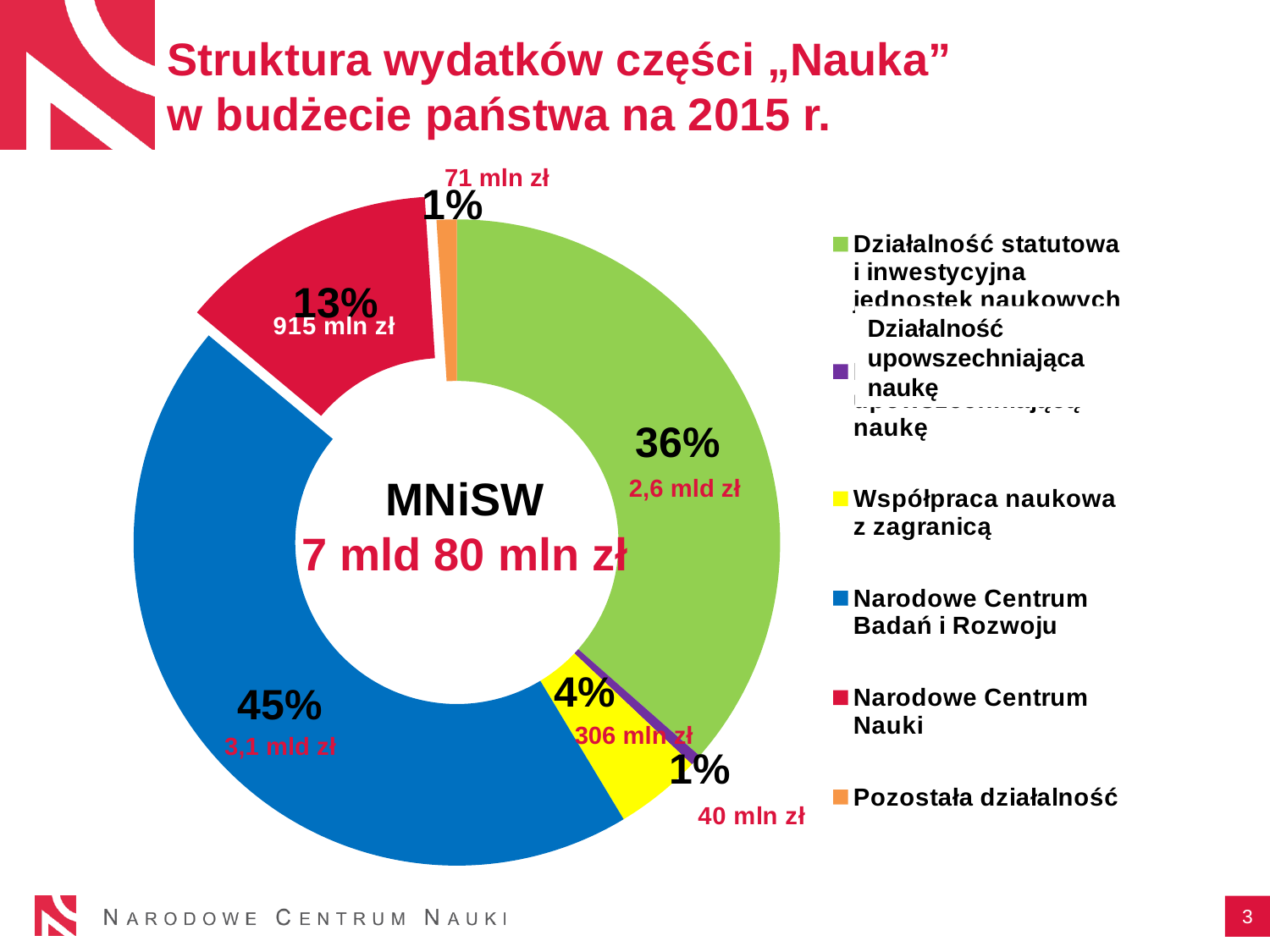
What total amount is shown in the centre of the chart? 7 mld 80 mln zł Which category has the largest share of the chart? Narodowe Centrum Badań i Rozwoju What kind of chart is shown on the slide? Doughnut (pie) chart What share of the chart does Narodowe Centrum Badań i Rozwoju hold? 45% What is the difference in percentage points between the share for Narodowe Centrum Badań i Rozwoju and the share for Działalność statutowa i inwestycyjna jednostek naukowych? 9 percentage points What share of the chart does Narodowe Centrum Nauki hold? 13% How many categories does the legend list? 6 Which is larger: the share for Narodowe Centrum Nauki or the share for Współpraca naukowa z zagranicą? Narodowe Centrum Nauki What amount is labelled for Narodowe Centrum Badań i Rozwoju? 3,1 mld zł What share of the chart does Działalność statutowa i inwestycyjna jednostek naukowych hold? 36% What amount is labelled for Współpraca naukowa z zagranicą? 306 mln zł What amount is labelled for Narodowe Centrum Nauki? 915 mln zł